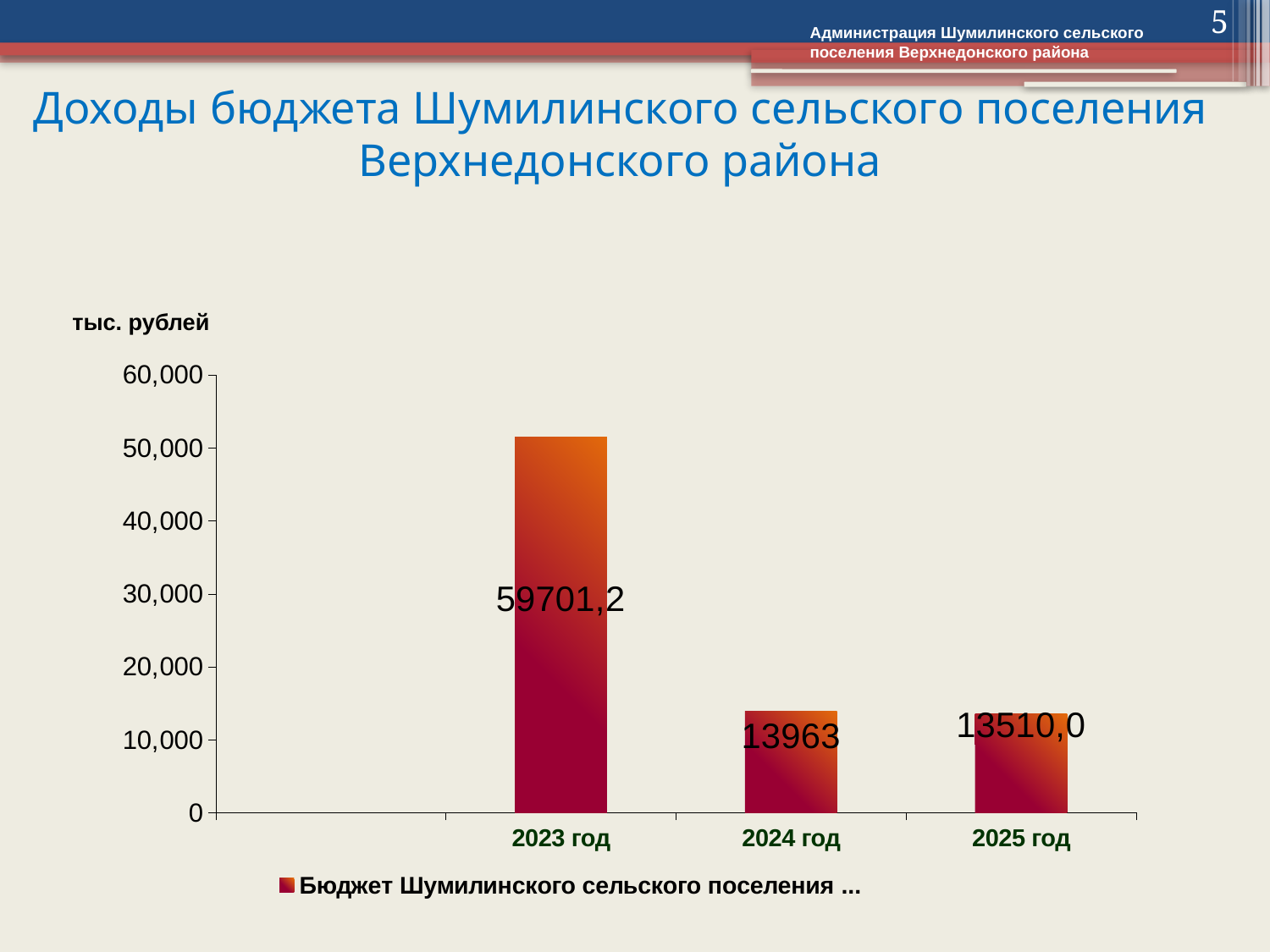
What kind of chart is shown? bar chart How many years are shown on the x axis? 3 What is the difference between the values for 2024 год and 2025 год? 453 Which year has the lowest value? 2025 год What is the value for 2023 год? 59701,2 Which year has the highest value? 2023 год Is the value for 2024 год greater or less than 20,000? less Which is larger, the value for 2024 год or the value for 2025 год? 2024 год How many series does the legend list? 1 What is the value for 2025 год? 13510,0 What unit is indicated above the vertical axis? тыс. рублей What is the value for 2024 год? 13963